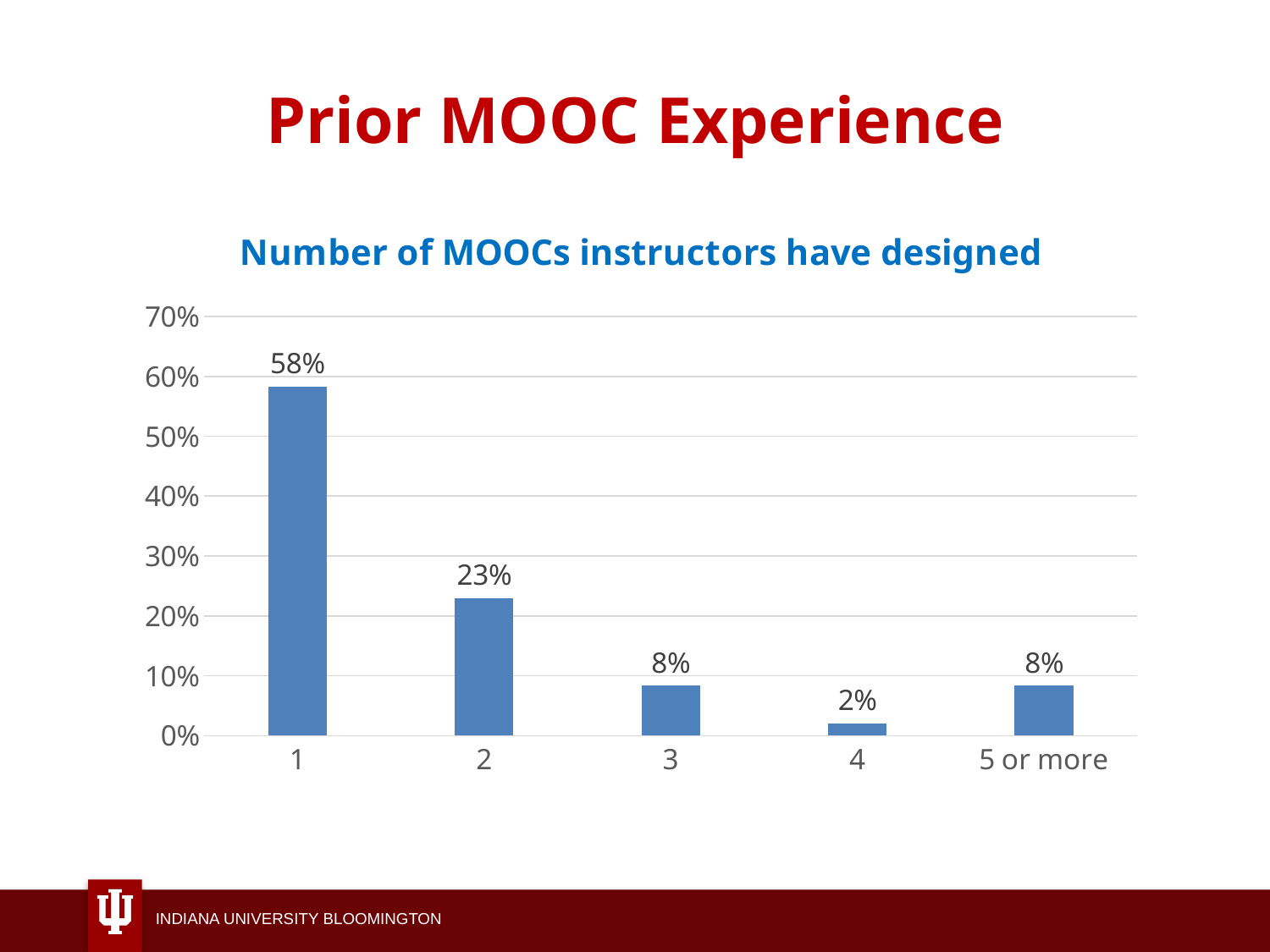
What percentage of instructors have designed 5 or more MOOCs? 8% What is the difference between the percentages for 1 MOOC and 2 MOOCs? 35% Which category has the highest percentage? 1 Which category has the lowest percentage? 4 Which is larger, the percentage for 2 MOOCs or for 3 MOOCs? 2 What percentage of instructors have designed 2 MOOCs? 23% What percentage of instructors have designed 1 MOOC? 58% What percentage of instructors have designed 4 MOOCs? 2% Is the value for 1 MOOC greater or less than 50%? greater How many categories are shown on the x axis? 5 What kind of chart is shown on the slide? Bar chart What is the title of the chart? Number of MOOCs instructors have designed